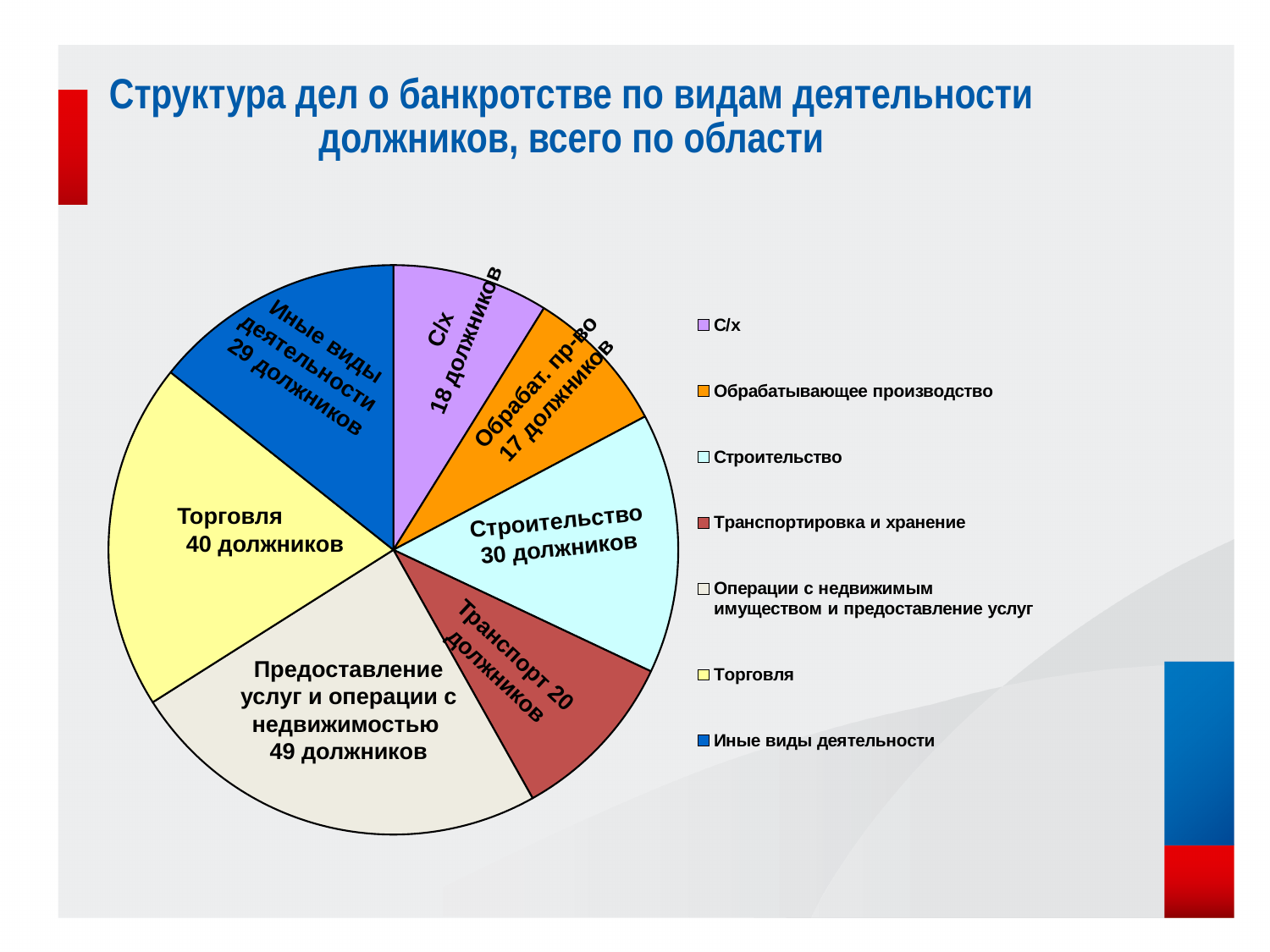
What kind of chart is shown on the slide? Pie chart Which category has the largest number of debtors? Предоставление услуг и операции с недвижимостью (49 должников) How many debtors are in the Строительство slice? 30 должников How many debtors are in the Торговля slice? 40 должников What is the difference in debtors between Торговля and Иные виды деятельности? 11 Which category has the smallest number of debtors? Обрабат. пр-во (17 должников) Which has more debtors, Строительство or Транспорт? Строительство How many debtors are in the Транспорт slice? 20 должников What colour is the Торговля slice? Yellow How many entries does the legend list? 7 How many slices does the pie chart have? 7 How many debtors are in the С/х slice? 18 должников